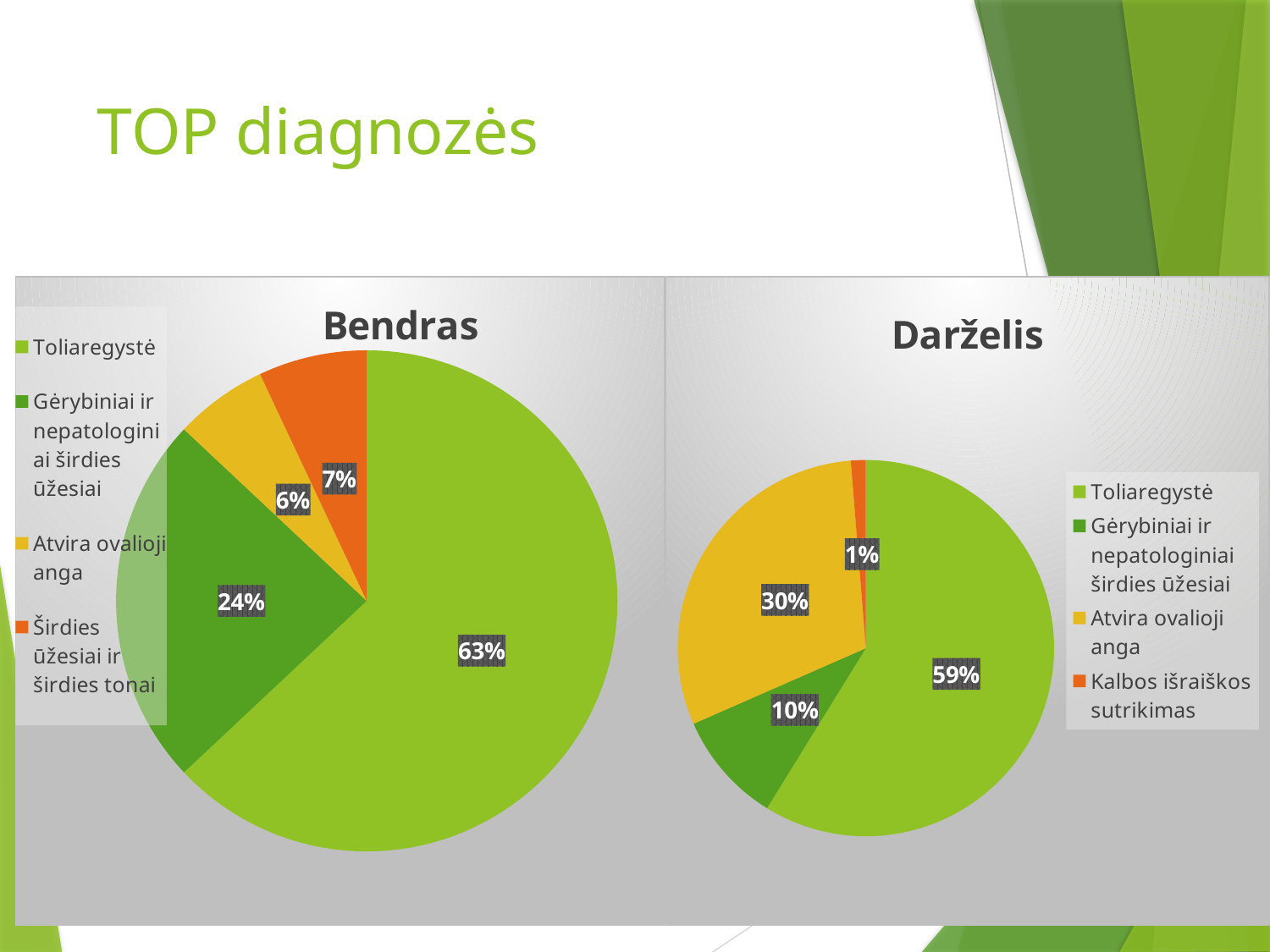
How many categories does the "Darželis" chart show? 4 In the "Darželis" chart, what share does Atvira ovalioji anga have? 30% In the "Darželis" chart, which category has the largest slice? Toliaregystė What type of chart is the "Bendras" chart? Pie chart In the "Bendras" chart, which category has the smallest slice? Atvira ovalioji anga In the "Bendras" chart, what is the value for Širdies ūžesiai ir širdies tonai? 7% In the "Bendras" chart, what is the value for Gėrybiniai ir nepatologiniai širdies ūžesiai? 24% In the "Bendras" chart, what share does Toliaregystė have? 63% In the "Bendras" chart, what is the difference between Toliaregystė and Gėrybiniai ir nepatologiniai širdies ūžesiai? 39% In the "Darželis" chart, which is larger: Atvira ovalioji anga or Gėrybiniai ir nepatologiniai širdies ūžesiai? Atvira ovalioji anga In the "Darželis" chart, which category has the smallest slice? Kalbos išraiškos sutrikimas In the "Darželis" chart, what is the value for Kalbos išraiškos sutrikimas? 1%